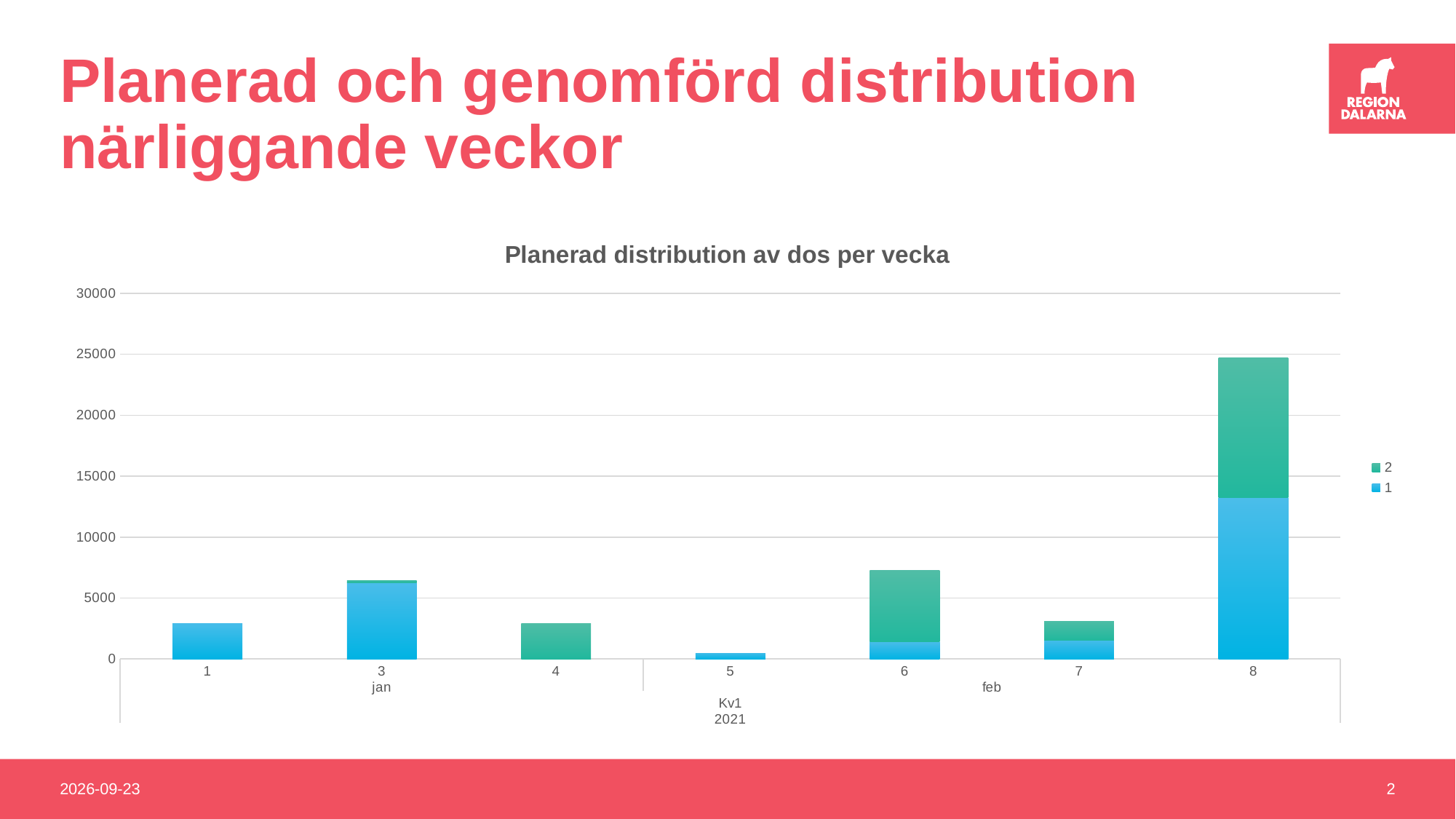
What are the two entries listed in the legend? 2 and 1 Which week has the highest total planned distribution? 8 How many weeks (bars) are shown on the x axis? 7 How many series does the legend list? 2 Is the total value for week 6 greater or less than 5000? greater Is the total value for week 1 greater or less than 5000? less Is the total value for week 8 greater or less than 20000? greater What kind of chart is shown on the slide? Stacked bar chart Which week has a larger total, week 6 or week 7? 6 What is the title of the chart? Planerad distribution av dos per vecka Which week has the lowest total planned distribution? 5